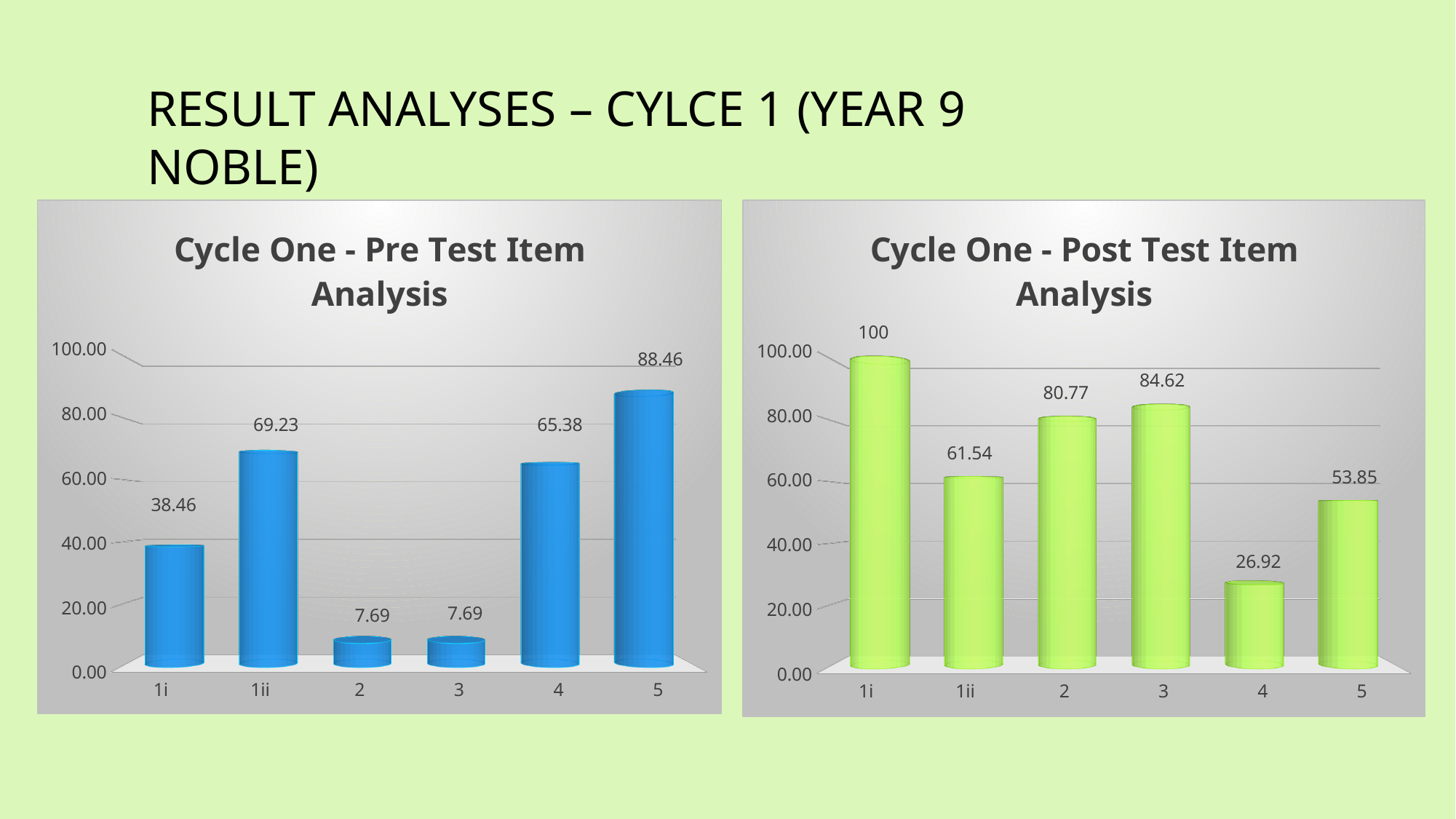
In the 'Cycle One - Post Test Item Analysis' chart, which item has the highest value? 1i In the 'Cycle One - Post Test Item Analysis' chart, is the value for item 5 greater or less than 60.00? less What kind of chart is the 'Cycle One - Post Test Item Analysis' chart? bar chart In the 'Cycle One - Pre Test Item Analysis' chart, what is the difference between the values for item 5 and item 1i? 50 In the 'Cycle One - Post Test Item Analysis' chart, what is the difference between the values for item 3 and item 2? 3.85 In the 'Cycle One - Pre Test Item Analysis' chart, what is the value for item 1ii? 69.23 In the 'Cycle One - Post Test Item Analysis' chart, which item has the lowest value? 4 What colour are the bars in the 'Cycle One - Pre Test Item Analysis' chart? blue In the 'Cycle One - Post Test Item Analysis' chart, what is the value for item 4? 26.92 In the 'Cycle One - Pre Test Item Analysis' chart, which item has the highest value? 5 In the 'Cycle One - Pre Test Item Analysis' chart, which is larger, the value for item 1ii or item 4? 1ii How many items are shown on the x axis of the 'Cycle One - Pre Test Item Analysis' chart? 6